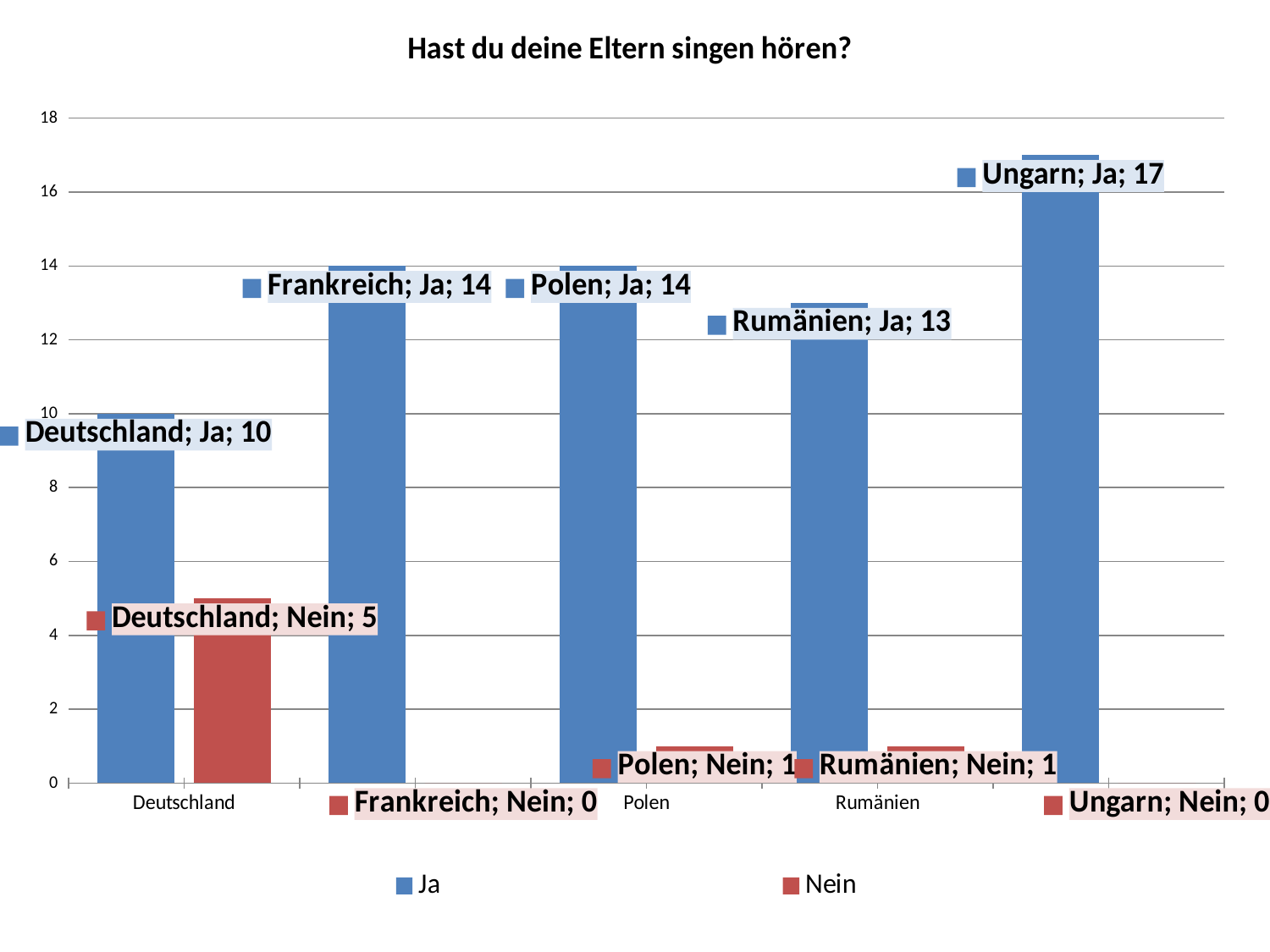
Which country has the highest value for Nein? Deutschland What kind of chart is shown? Bar chart What is the value for Ja in Ungarn? 17 What is the value for Nein in Deutschland? 5 How many countries are shown on the x axis? 5 What is the value for Ja in Rumänien? 13 What is the difference between the Ja values for Ungarn and Deutschland? 7 Which country has the lowest value for Ja? Deutschland How many series does the legend list? 2 What is the value for Nein in Polen? 1 Which is larger, the Ja value for Rumänien or the Ja value for Polen? Polen Which country has the highest value for Ja? Ungarn